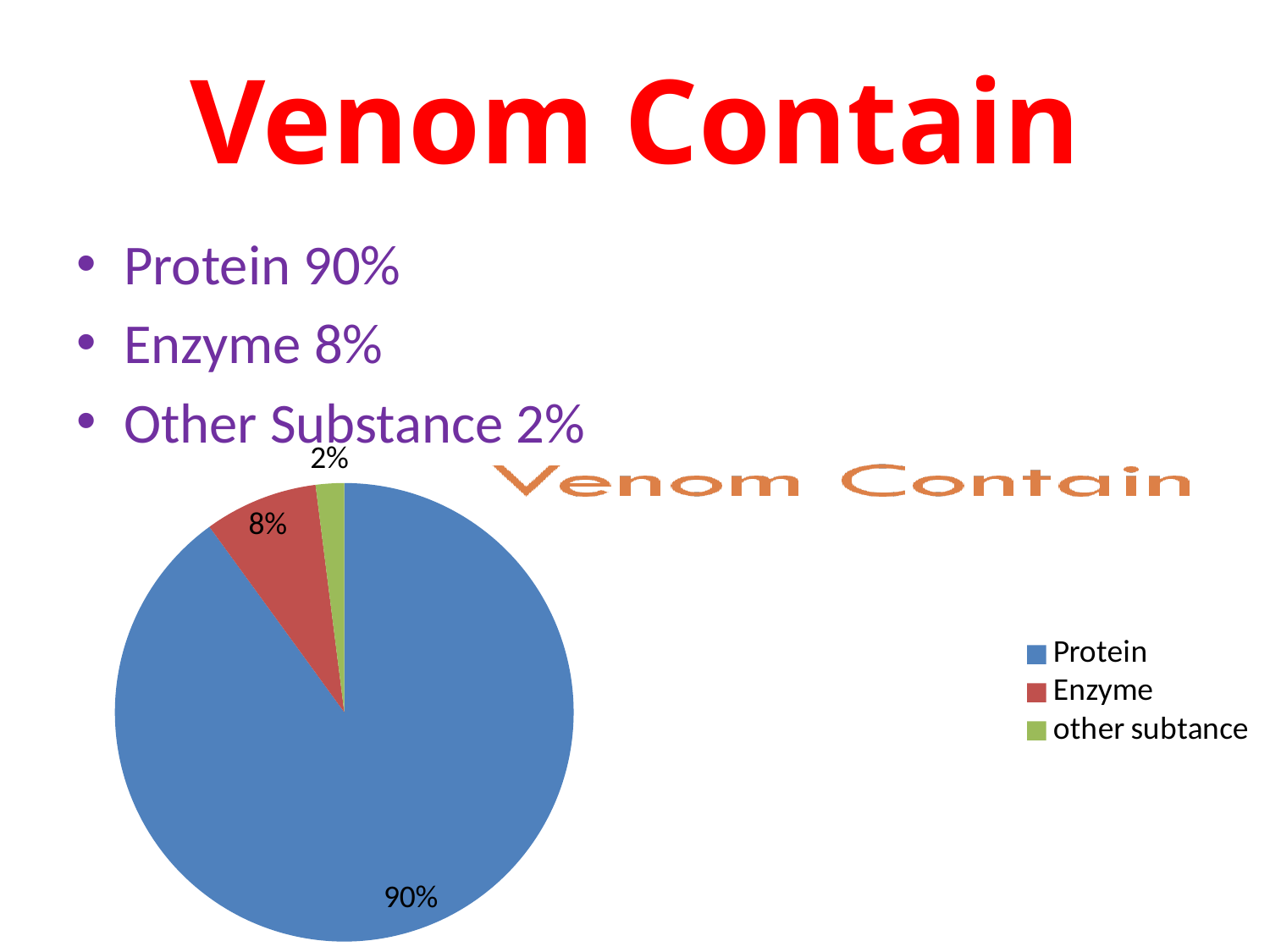
What share of the pie does Enzyme take? 8% What colour is the Protein slice in the pie chart? blue What share of the pie does other subtance take? 2% Which category has the smallest slice of the pie? other subtance Which slice is larger, Enzyme or other subtance? Enzyme What is the title of the chart? Venom Contain What share of the pie does Protein take? 90% How many slices does the pie chart have? 3 How many entries does the legend list? 3 Which category has the largest slice of the pie? Protein What kind of chart is shown on the slide? pie chart What is the difference in percentage points between the Protein slice and the Enzyme slice? 82